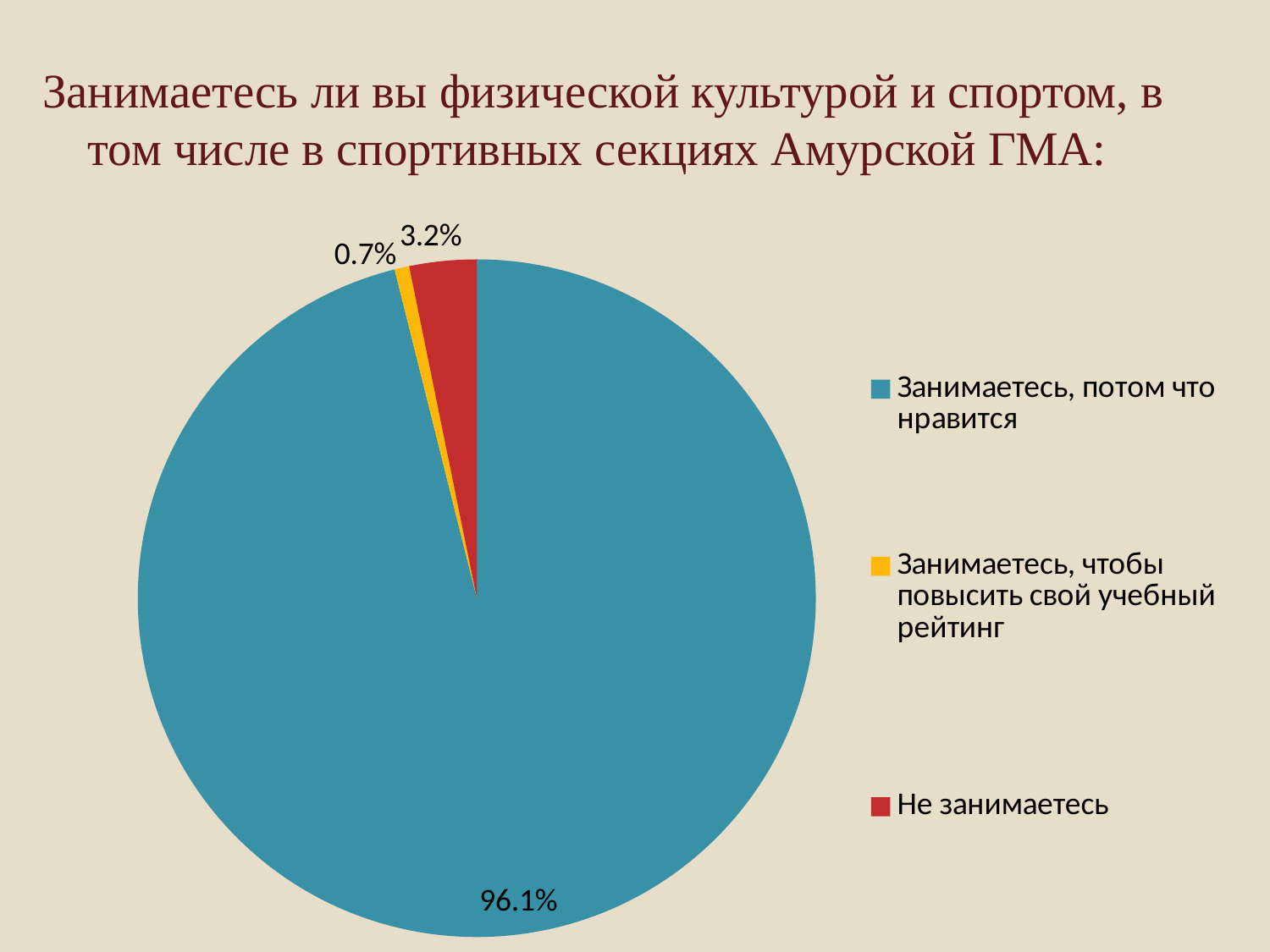
What share of the pie is labelled "Не занимаетесь"? 3.2% Which category has the smallest slice of the pie? Занимаетесь, чтобы повысить свой учебный рейтинг Which category has the largest slice of the pie? Занимаетесь, потом что нравится What share of the pie is labelled "Занимаетесь, чтобы повысить свой учебный рейтинг"? 0.7% Which is larger: the share for "Не занимаетесь" or the share for "Занимаетесь, чтобы повысить свой учебный рейтинг"? Не занимаетесь What share of the pie is labelled "Занимаетесь, потом что нравится"? 96.1% What is the difference between the shares for "Не занимаетесь" and "Занимаетесь, чтобы повысить свой учебный рейтинг"? 2.5% How many entries does the legend list? 3 What colour is the slice for "Занимаетесь, чтобы повысить свой учебный рейтинг"? yellow What colour is the slice for "Не занимаетесь"? red How many slices does the pie chart have? 3 What kind of chart is shown on the slide? pie chart